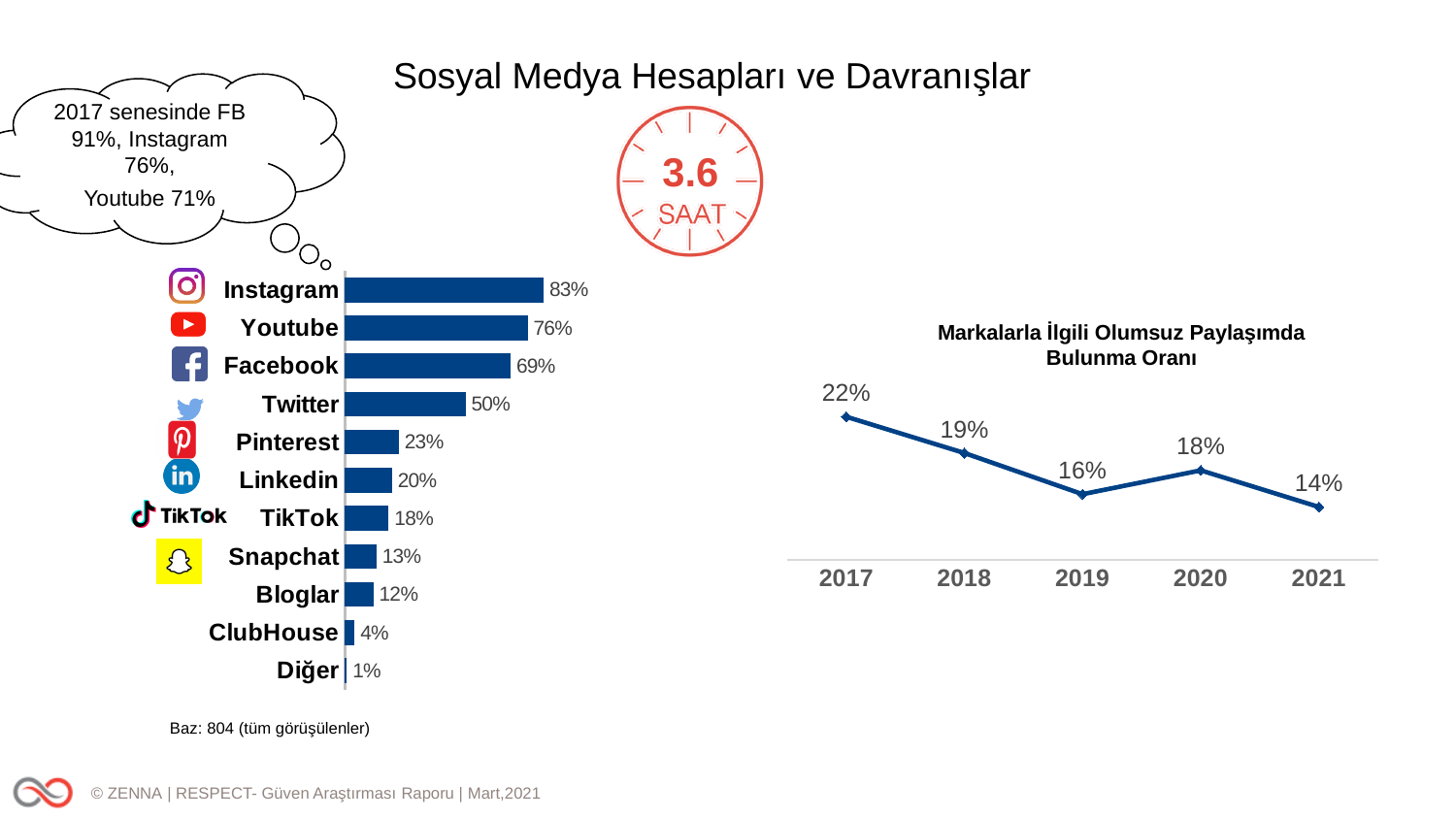
How many categories does the bar chart on the left show? 11 In the bar chart on the left, which category has the lowest value? Diğer In the chart titled 'Markalarla İlgili Olumsuz Paylaşımda Bulunma Oranı', what is the difference between the values for 2017 and 2021? 8% In the bar chart on the left, what is the difference between the values for Youtube and Facebook? 7% What kind of chart is the chart on the left? bar chart In the chart titled 'Markalarla İlgili Olumsuz Paylaşımda Bulunma Oranı', which year has the highest value? 2017 In the bar chart on the left, which category has the highest value? Instagram In the bar chart on the left, what is the value for Instagram? 83% In the bar chart on the left, what is the value for Pinterest? 23% In the bar chart on the left, which is larger, the value for Linkedin or the value for TikTok? Linkedin In the chart titled 'Markalarla İlgili Olumsuz Paylaşımda Bulunma Oranı', what is the value for 2019? 16% What kind of chart is the chart titled 'Markalarla İlgili Olumsuz Paylaşımda Bulunma Oranı'? line chart